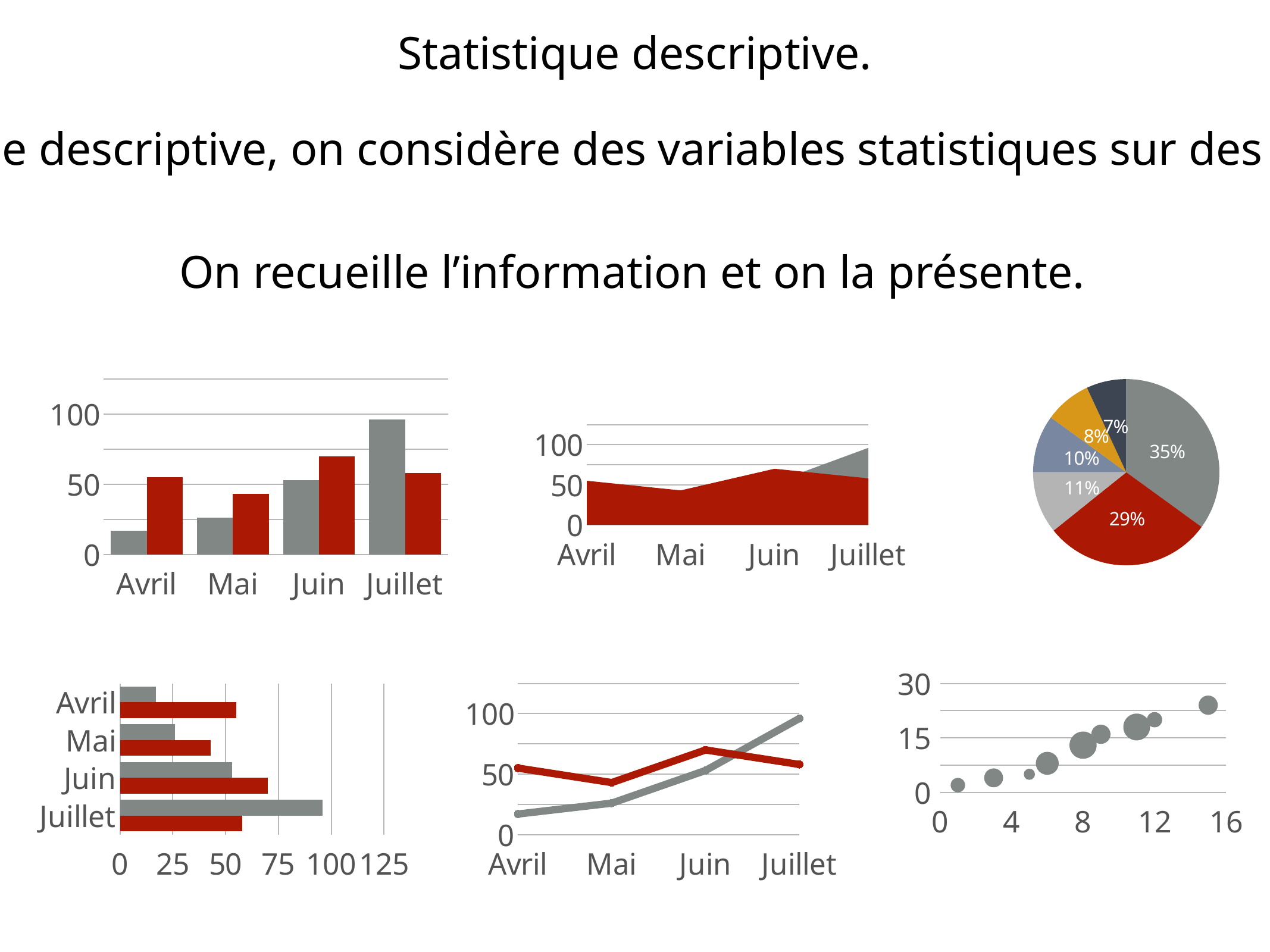
In the top-left bar chart, is the value of the red bar for Mai greater or less than 50? less In the top-left bar chart, which category has the tallest grey bar? Juillet What kind of chart is the top-right chart on the slide? pie chart In the top-right pie chart, what is the difference between the two largest slices (35% and 29%)? 6 percentage points In the bottom-middle line chart, does the grey line rise or fall from Avril to Juillet? rise What kind of chart is the top-left chart on the slide? bar chart In the top-right pie chart, what is the share of the smallest slice? 7% How many points are plotted in the bottom-right scatter chart? 9 How many slices does the top-right pie chart have? 6 What kind of chart is the bottom-middle chart on the slide? line chart How many categories are shown on the x axis of the top-left bar chart? 4 In the top-right pie chart, what is the share of the largest slice? 35%